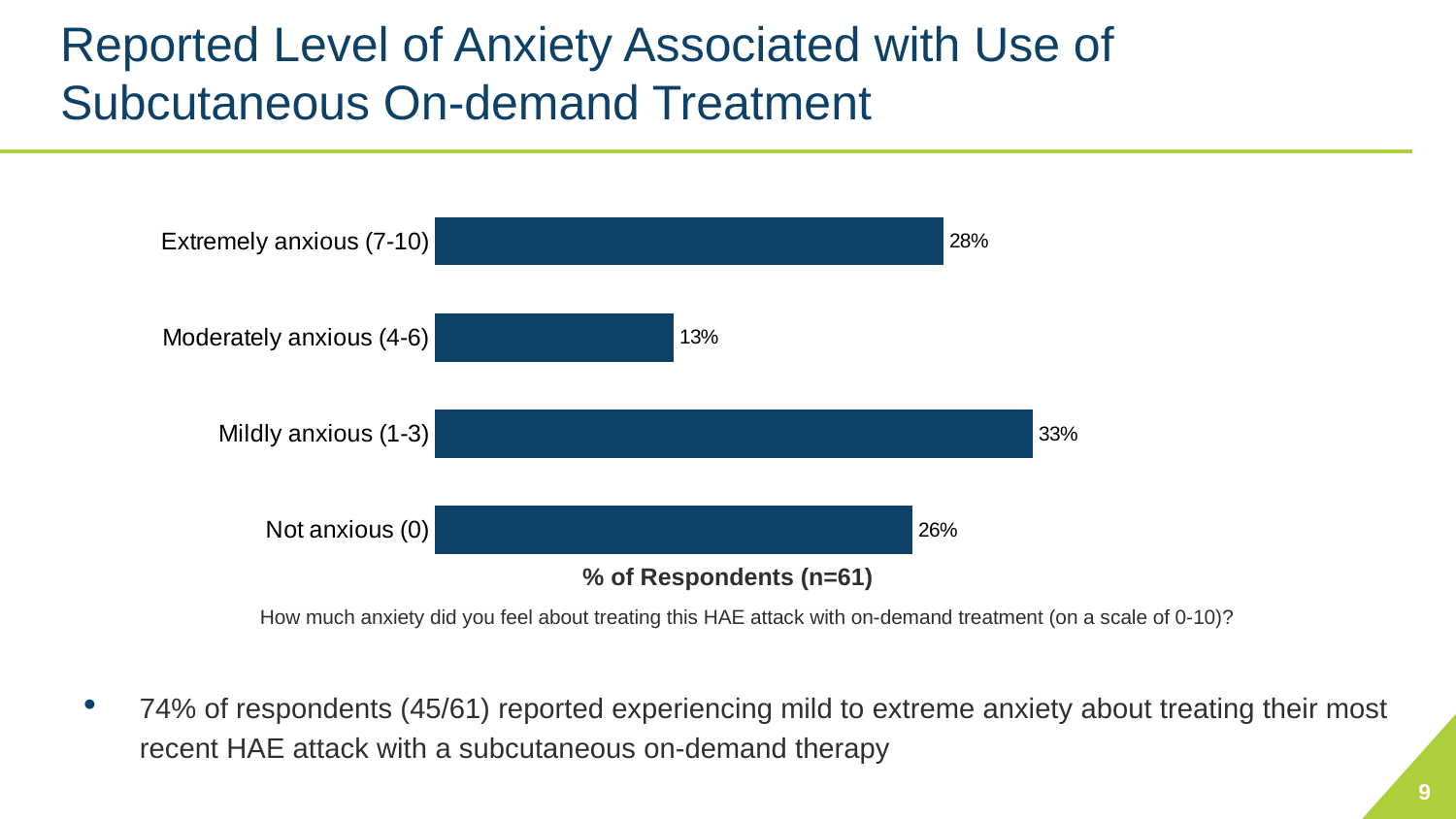
Which anxiety level category has the highest percentage of respondents? Mildly anxious (1-3) What percentage of respondents reported being not anxious (0)? 26% What type of chart is shown on the slide? Bar chart What percentage of respondents reported being extremely anxious (7-10)? 28% What percentage of respondents reported being moderately anxious (4-6)? 13% What is the label of the horizontal axis of the chart? % of Respondents (n=61) Which anxiety level category has the lowest percentage of respondents? Moderately anxious (4-6) What is the difference in percentage points between the extremely anxious (7-10) and not anxious (0) categories? 2 What percentage of respondents reported being mildly anxious (1-3)? 33% Which category has a larger percentage of respondents: extremely anxious (7-10) or not anxious (0)? Extremely anxious (7-10) What is the difference in percentage points between the mildly anxious (1-3) and moderately anxious (4-6) categories? 20 How many anxiety level categories are shown in the chart? 4